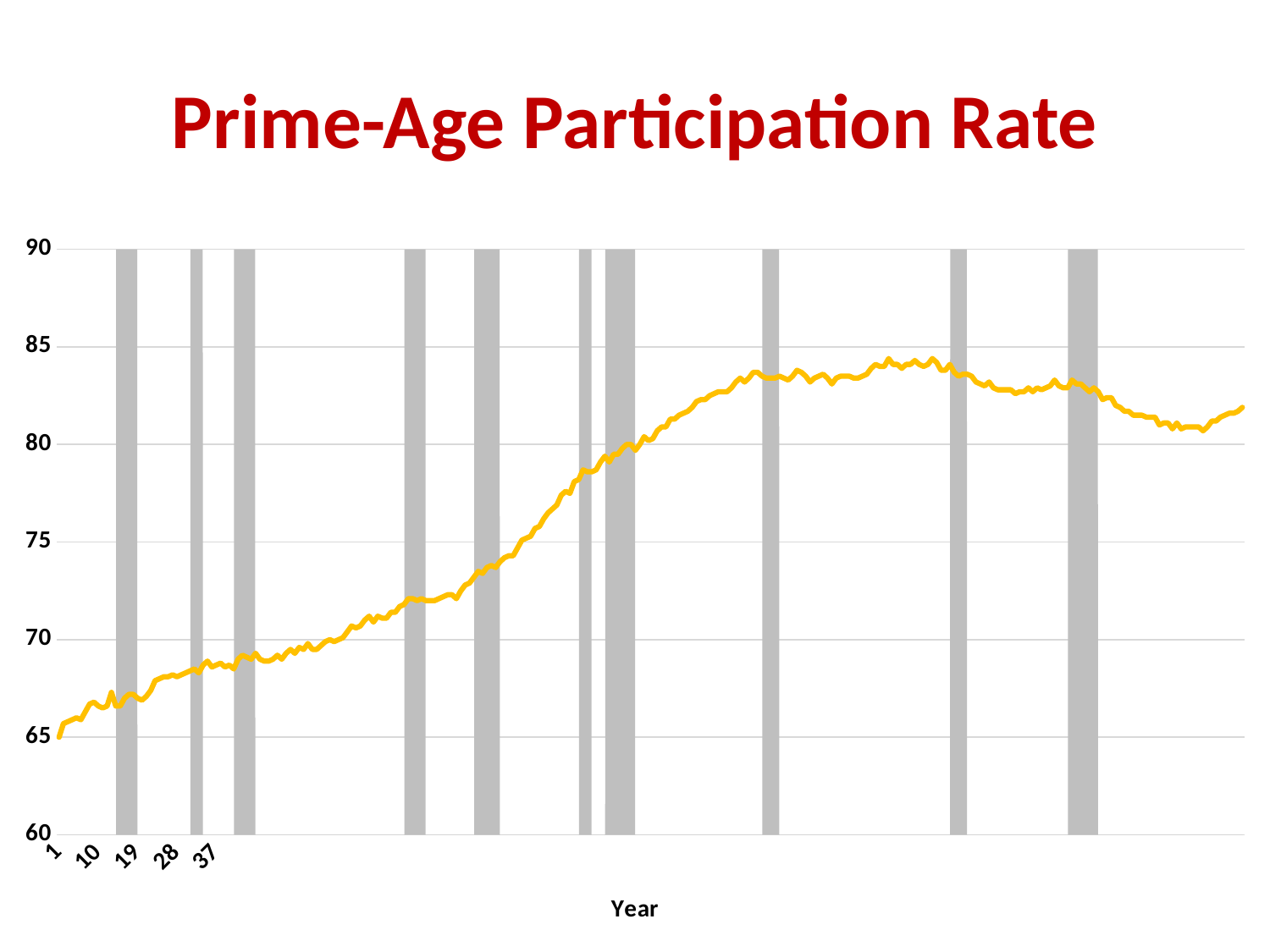
Is the value at year 37 greater or less than 70? less What is the title of the chart? Prime-Age Participation Rate Is the value at year 1 greater or less than 70? less Is the value at the right-hand end of the line greater or less than 85? less What is the highest value shown on the y axis? 90 Does the line rise or fall between year 1 and year 37? rise Is the value at year 37 larger or smaller than the value at year 1? larger What kind of chart is shown on the slide? line chart What is the title of the x axis? Year